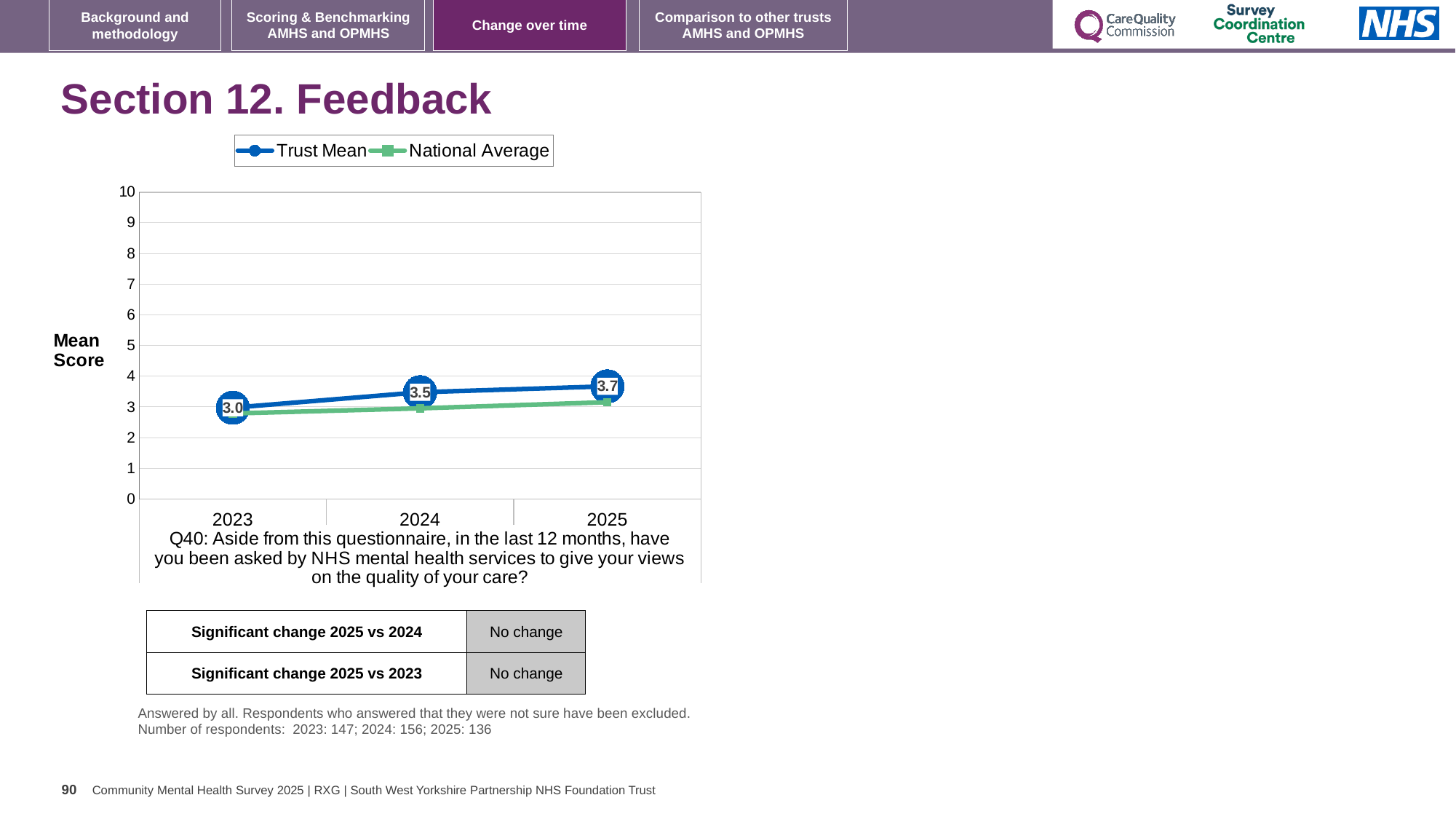
Is the National Average value for 2023 greater or less than 5? less In which year is the Trust Mean lowest? 2023 How many series does the legend list? 2 Does the Trust Mean rise or fall from 2023 to 2025? rise What is the difference between the Trust Mean in 2025 and in 2023? 0.7 What is the Trust Mean value for 2023? 3.0 How many years are shown on the x axis? 3 In which year is the Trust Mean highest? 2025 What kind of chart is shown on the slide? line chart What is the Trust Mean value for 2025? 3.7 What is the Trust Mean value for 2024? 3.5 In 2025, which series has the higher value, Trust Mean or National Average? Trust Mean